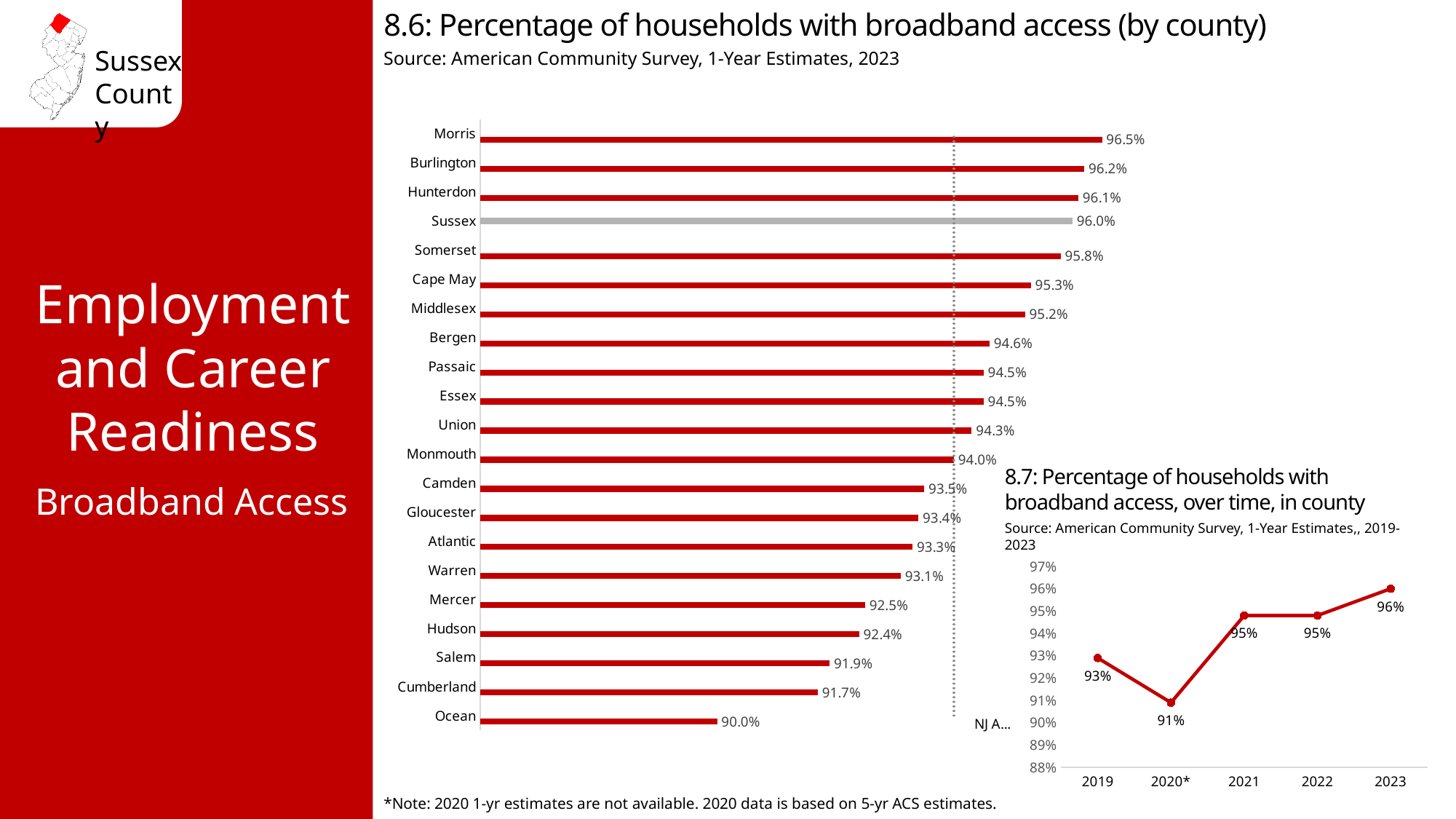
In chart 8.7, what is the difference between the 2023 and 2019 values? 3% In chart 8.6, what is the difference between Morris and Ocean counties? 6.5% In chart 8.7, what was the percentage of households with broadband access in 2020? 91% In chart 8.6, what is the value for Ocean County? 90.0% In chart 8.6, how many counties are shown? 21 In chart 8.6, which county has the highest percentage of households with broadband access? Morris In chart 8.6, which county has the lowest percentage of households with broadband access? Ocean In chart 8.6, which county has a higher value, Bergen or Camden? Bergen In chart 8.7, how many years are plotted? 5 What type of chart is chart 8.6? Bar chart In chart 8.7, which year has the highest value? 2023 In chart 8.6, what percentage of households in Sussex County have broadband access? 96.0%